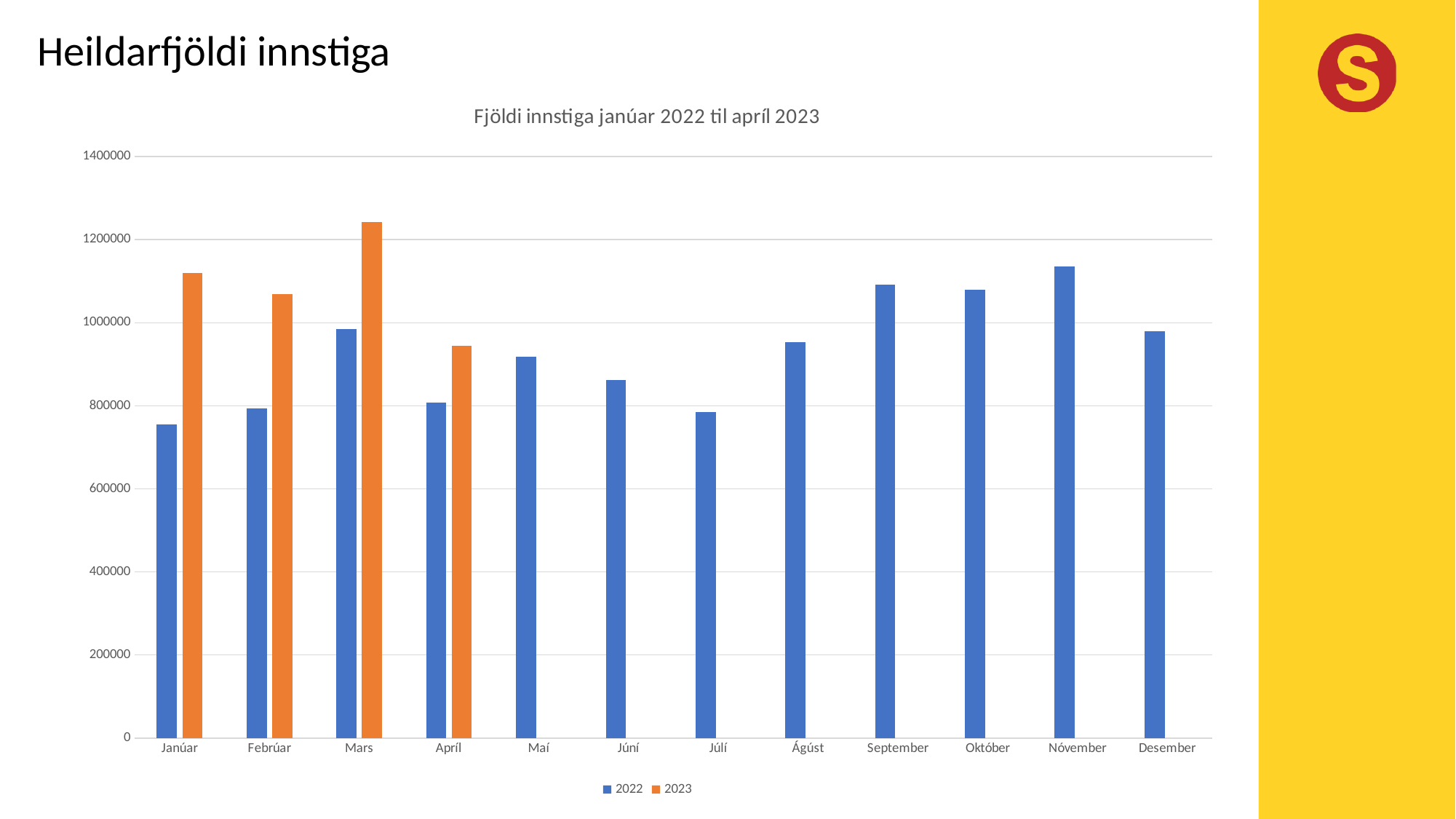
What kind of chart is shown on the slide? bar chart Which month has the lowest value for the 2023 series? Apríl What is the title of the chart? Fjöldi innstiga janúar 2022 til apríl 2023 How many series does the legend list? 2 Is the value for Mars 2023 greater or less than 1200000? greater Is the value for Janúar 2022 greater or less than 800000? less How many months are shown along the x axis? 12 Is the value for Apríl 2023 greater or less than 1000000? less Which month has the highest value for the 2022 series? Nóvember Which month has the highest value for the 2023 series? Mars Which is larger in Janúar: the 2022 value or the 2023 value? 2023 Do the 2022 values rise or fall from Maí to Júlí? fall